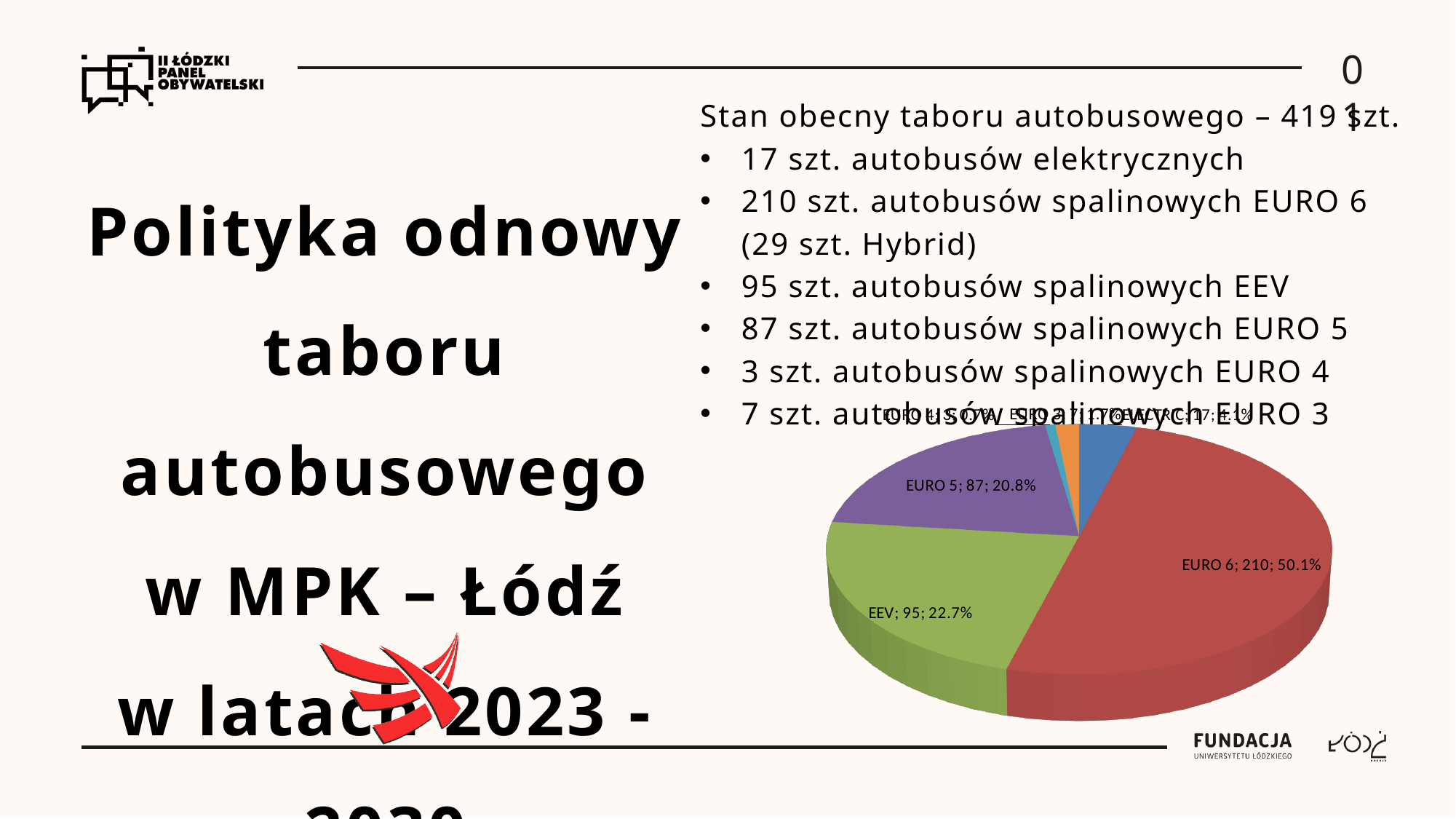
Which category has the largest slice in the pie chart? EURO 6 What kind of chart is shown on the slide? pie chart What is the difference between the EEV and EURO 5 values in the pie chart? 8 What share of the pie chart does the EEV slice take? 22.7% How many buses does the EURO 5 slice of the pie chart represent? 87 What is the difference between the EURO 6 and EEV values in the pie chart? 115 How many slices does the pie chart have? 6 Which slice is larger in the pie chart, EEV or EURO 5? EEV How many buses does the EURO 6 slice of the pie chart represent? 210 How many buses does the EEV slice of the pie chart represent? 95 What share of the pie chart does the EURO 5 slice take? 20.8% What share of the pie chart does the EURO 6 slice take? 50.1%